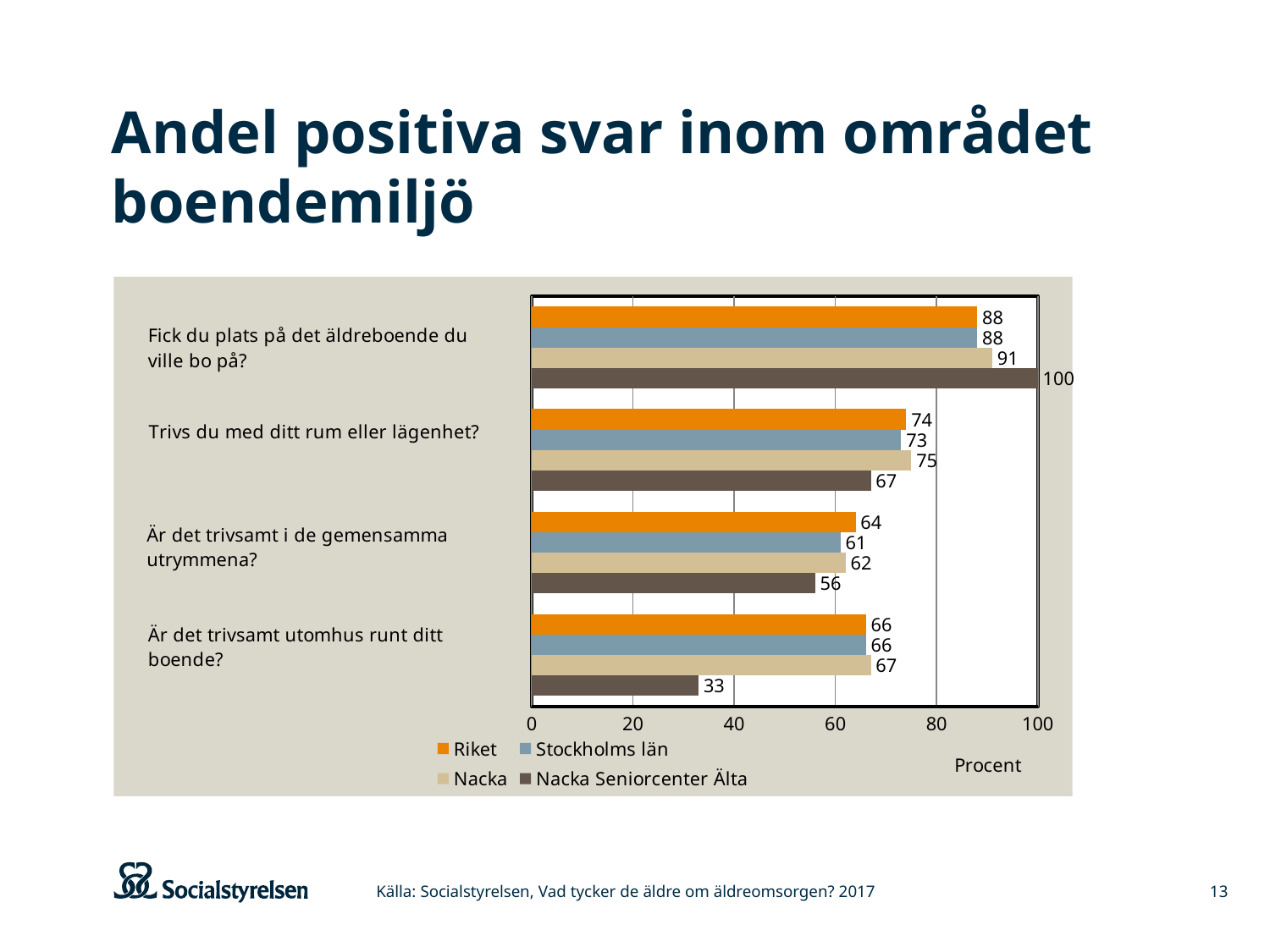
What is the value for Nacka Seniorcenter Älta on "Är det trivsamt utomhus runt ditt boende?"? 33 Which question has the lowest value for Nacka Seniorcenter Älta? Är det trivsamt utomhus runt ditt boende? What is the value for Nacka on "Trivs du med ditt rum eller lägenhet?"? 75 On "Trivs du med ditt rum eller lägenhet?", which is larger: the value for Nacka or the value for Nacka Seniorcenter Älta? Nacka What is the value for Stockholms län on "Är det trivsamt i de gemensamma utrymmena?"? 61 What is the value for Nacka Seniorcenter Älta on "Fick du plats på det äldreboende du ville bo på?"? 100 What is the difference between the Nacka value and the Nacka Seniorcenter Älta value on "Är det trivsamt utomhus runt ditt boende?"? 34 Which question has the highest value for Riket? Fick du plats på det äldreboende du ville bo på? How many questions (categories) are shown on the chart? 4 How many series does the legend list? 4 What is the label on the horizontal axis of the chart? Procent What kind of chart is shown on the slide? Bar chart